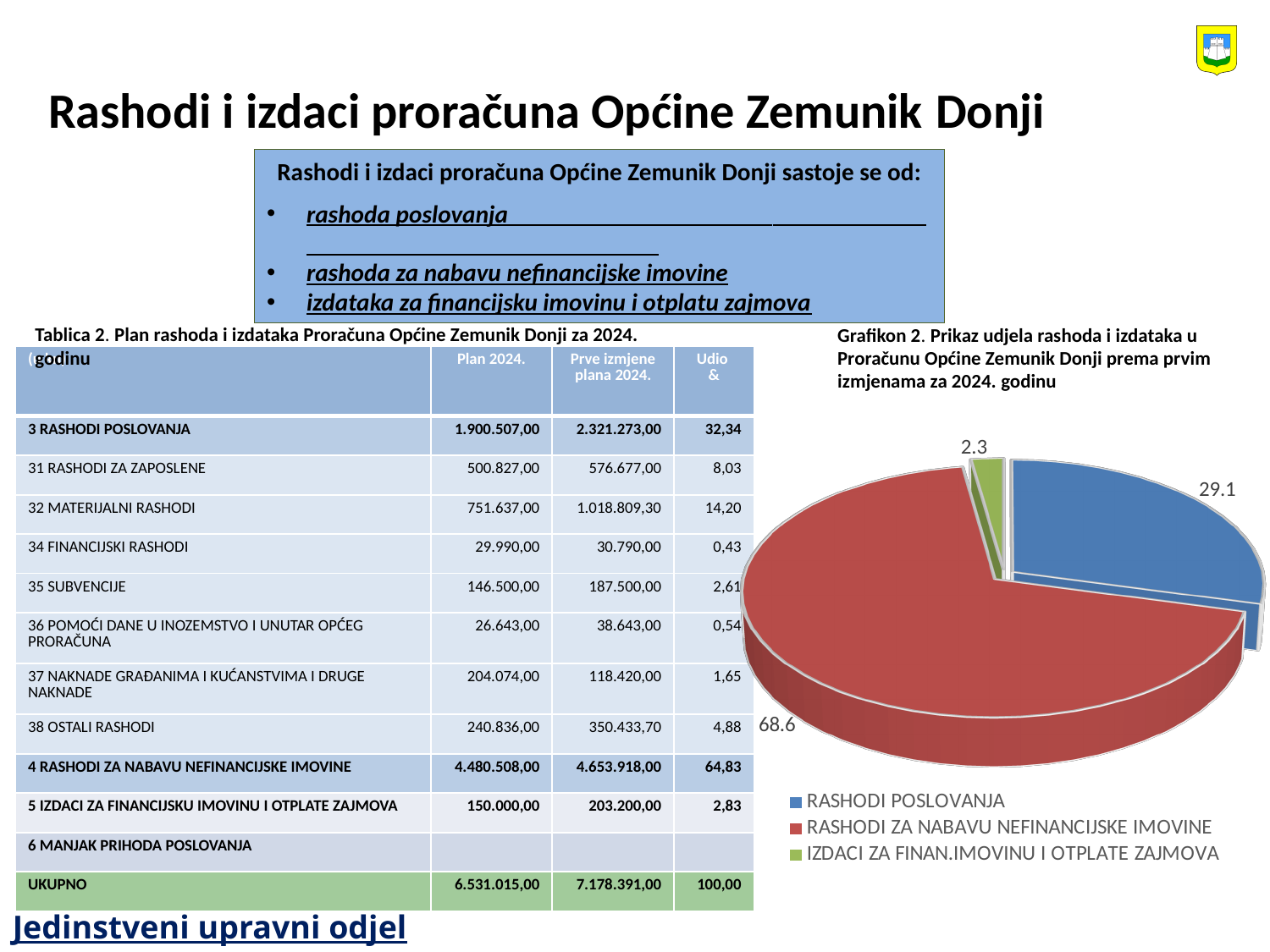
What type of chart is shown on the slide? pie chart How many slices does the pie chart have? 3 What is the value shown for IZDACI ZA FINAN.IMOVINU I OTPLATE ZAJMOVA in the pie chart? 2.3 What is the difference between the values for RASHODI ZA NABAVU NEFINANCIJSKE IMOVINE and RASHODI POSLOVANJA in the pie chart? 39.5 Which category has the smallest slice in the pie chart? IZDACI ZA FINAN.IMOVINU I OTPLATE ZAJMOVA What is the value shown for RASHODI POSLOVANJA in the pie chart? 29.1 Which category has the largest slice in the pie chart? RASHODI ZA NABAVU NEFINANCIJSKE IMOVINE What colour is the slice for RASHODI ZA NABAVU NEFINANCIJSKE IMOVINE in the pie chart? red What is the value shown for RASHODI ZA NABAVU NEFINANCIJSKE IMOVINE in the pie chart? 68.6 Which is larger in the pie chart: RASHODI POSLOVANJA or IZDACI ZA FINAN.IMOVINU I OTPLATE ZAJMOVA? RASHODI POSLOVANJA How many entries does the pie chart legend list? 3 What is the difference between the values for RASHODI POSLOVANJA and IZDACI ZA FINAN.IMOVINU I OTPLATE ZAJMOVA in the pie chart? 26.8